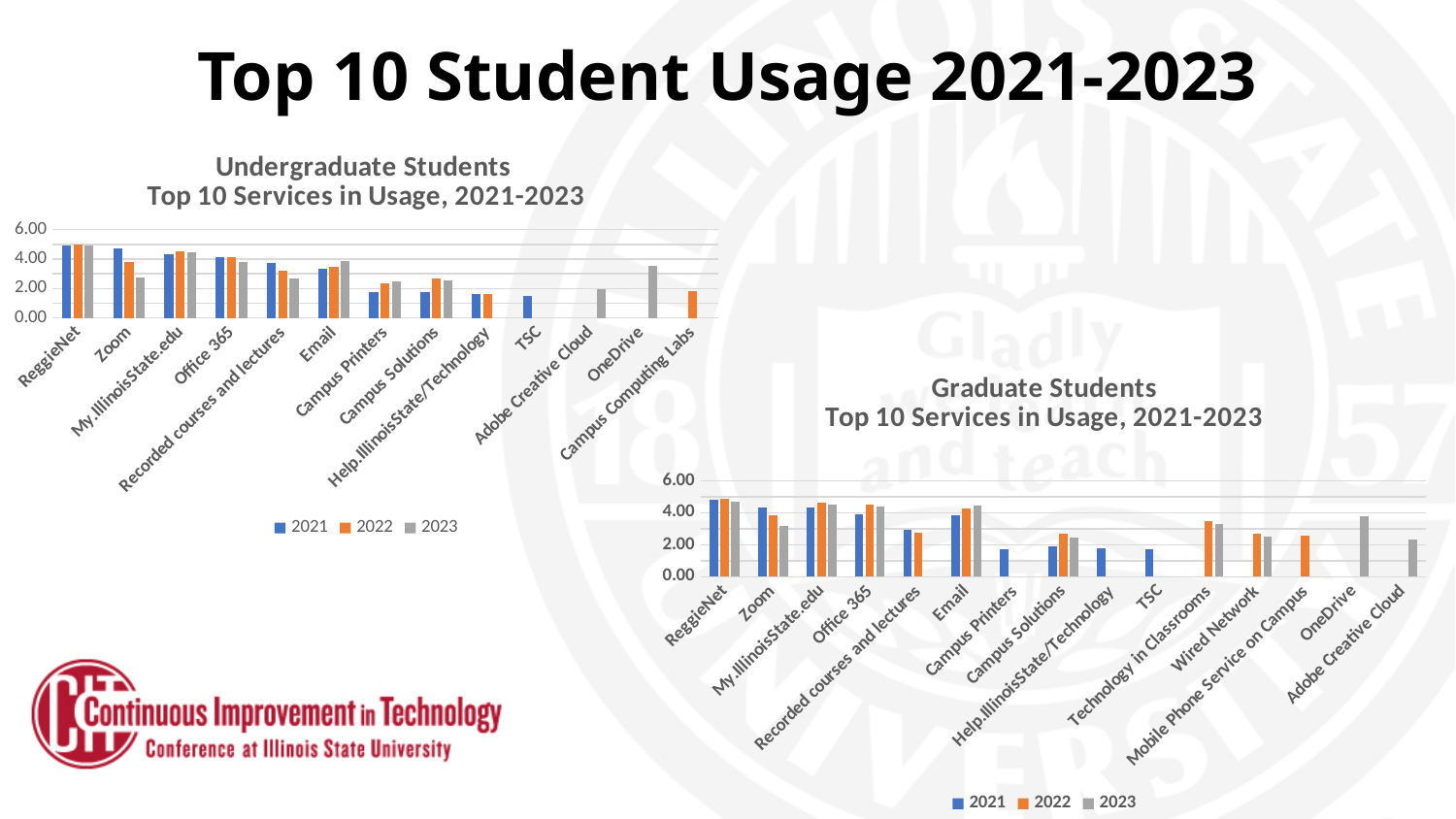
In the Graduate Students chart, is the 2022 value for ReggieNet greater or less than 4.00? greater In the Graduate Students chart, is the 2021 value for Campus Printers greater or less than 2.00? less How many series does the legend of the Graduate Students chart list? 3 How many service categories are shown on the x axis of the Graduate Students chart? 15 In the Undergraduate Students chart, is the 2023 value for OneDrive greater or less than 2.00? greater What kind of chart is the Undergraduate Students chart? Bar chart How many service categories are shown on the x axis of the Undergraduate Students chart? 13 In the Undergraduate Students chart, which category has the highest 2023 value? ReggieNet In the Graduate Students chart, which colour represents the 2022 series? Orange In the Undergraduate Students chart, which is larger for Zoom: the 2022 value or the 2023 value? 2022